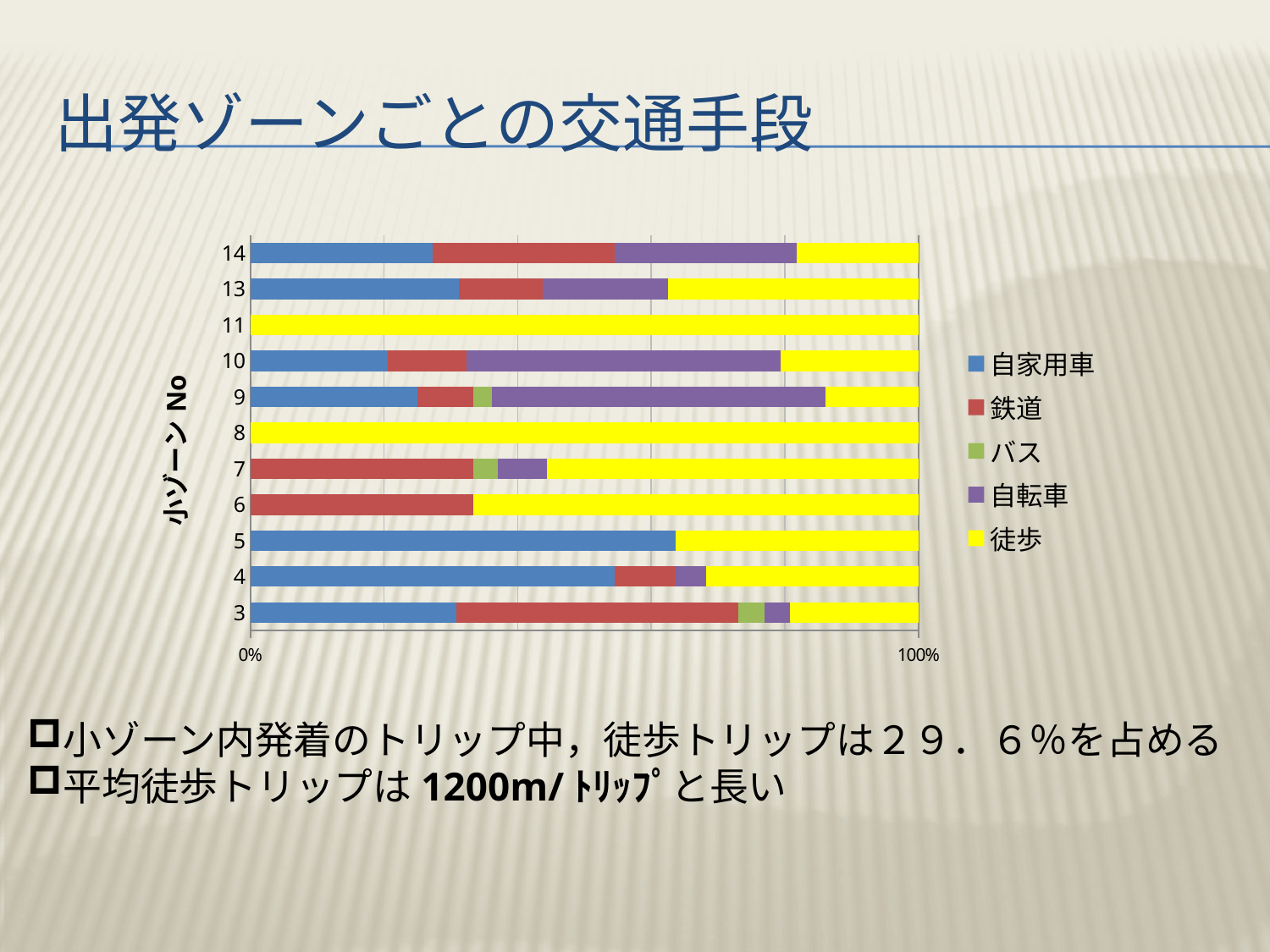
What is the 徒歩 share for zone 8? 100% Which zone has the larger 鉄道 share, zone 3 or zone 6? 3 How many series does the legend list? 5 What kind of chart is shown on the slide? stacked bar chart How many zones (categories) are plotted on the y axis? 11 How many zones consist entirely (100%) of 徒歩 trips? 2 What are the legend entries, in order from top to bottom? 自家用車, 鉄道, バス, 自転車, 徒歩 What is the 徒歩 share for zone 11? 100% In how many zones does the バス series appear? 3 What is the title of the y axis? 小ゾーン No Which zone has the largest 自家用車 share? 5 Which zone has the larger 自家用車 share, zone 5 or zone 4? 5